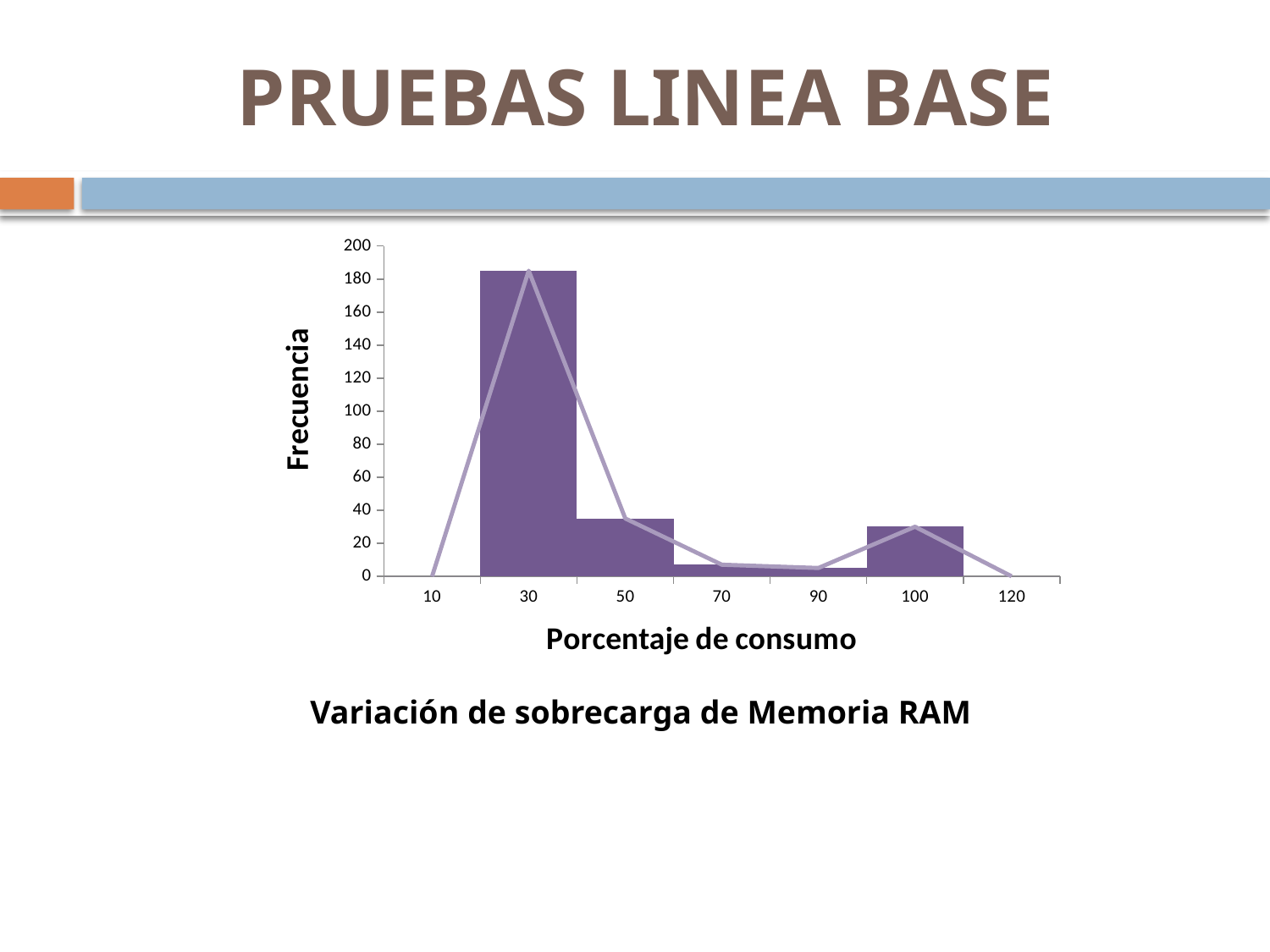
Is the Frecuencia for Porcentaje de consumo 30 greater or less than 160? greater Is the Frecuencia for Porcentaje de consumo 100 greater or less than 20? greater How many Porcentaje de consumo values are labelled on the x axis? 7 Is the Frecuencia for Porcentaje de consumo 70 greater or less than 20? less Which has a higher Frecuencia, Porcentaje de consumo 100 or 90? 100 What is the title of the x axis? Porcentaje de consumo What is the Frecuencia at Porcentaje de consumo 10? 0 What kind of chart is shown on the slide? bar chart with a line overlay Which has a higher Frecuencia, Porcentaje de consumo 30 or 50? 30 Do the Frecuencia values rise or fall from Porcentaje de consumo 30 to 90? fall Which value of Porcentaje de consumo has the highest Frecuencia? 30